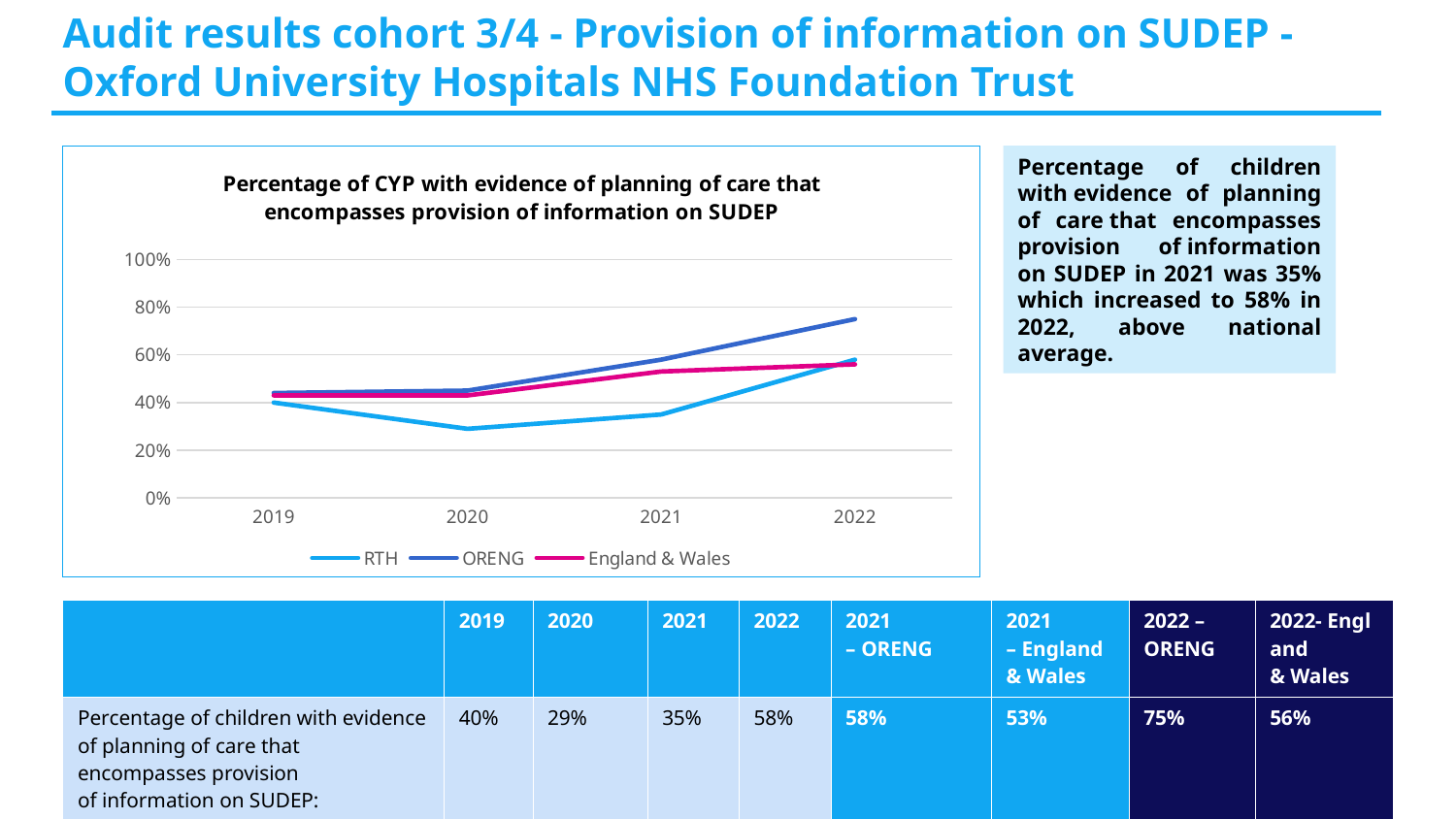
What is the RTH value for 2020? 29% By how many percentage points did the RTH value increase from 2021 to 2022? 23 percentage points What kind of chart is shown on the slide? Line chart Is the ORENG value for 2019 greater or less than 40%? greater How many series does the chart legend list? 3 What is the RTH value for 2022? 58% What is the ORENG value for 2022? 75% Which is larger in 2022, ORENG or RTH? ORENG In which year is the RTH series at its lowest? 2020 How many years are plotted along the x axis of the chart? 4 Which series are listed in the chart legend? RTH, ORENG, England & Wales In which year is the RTH series at its highest? 2022